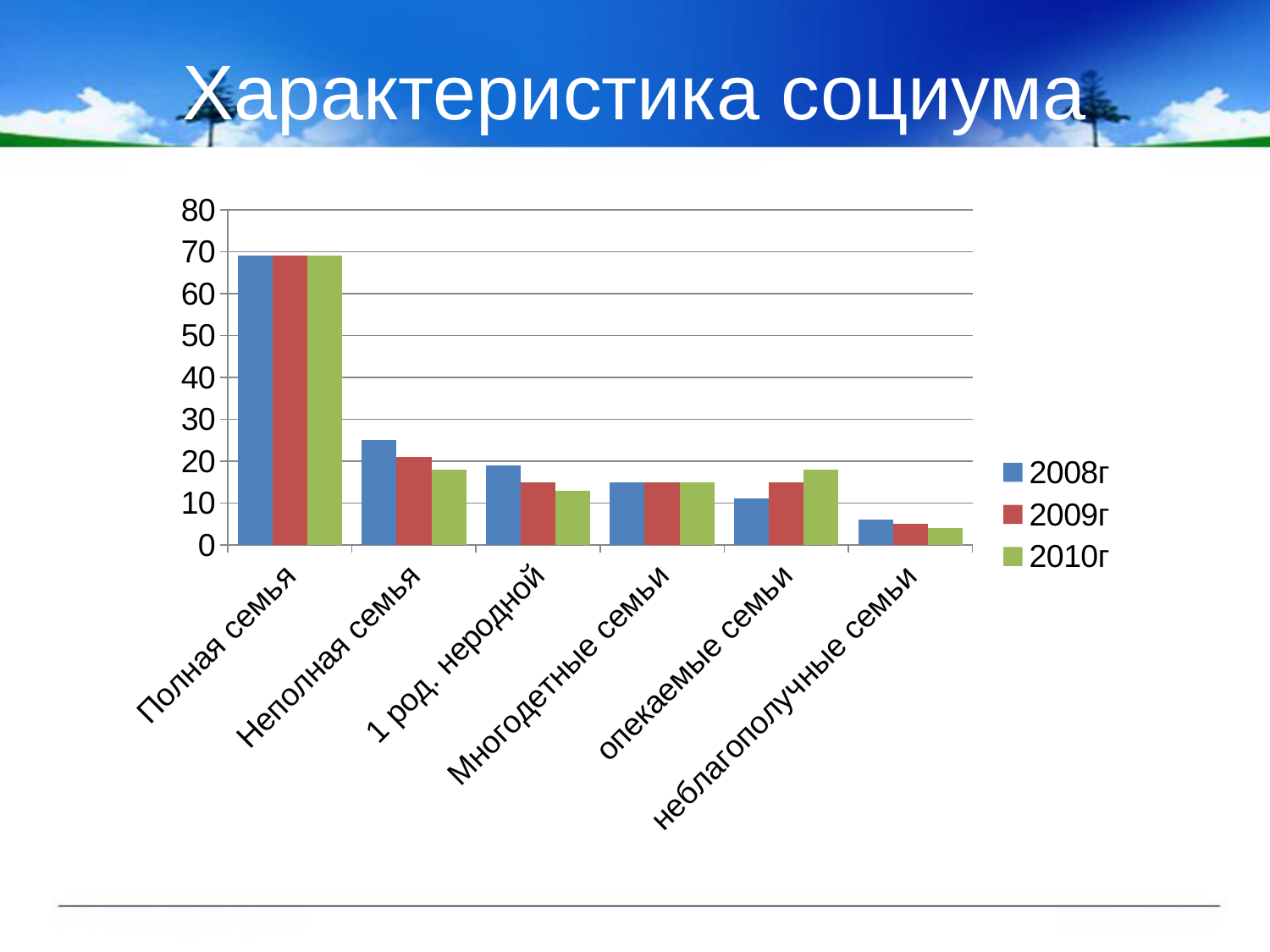
How many series does the legend list? 3 For опекаемые семьи, do the values rise or fall from 2008г to 2010г? rise How many categories are shown on the x axis? 6 For Неполная семья, which is larger: the value for 2008г or for 2010г? 2008г Which category has the lowest value for 2010г? неблагополучные семьи Is the value for неблагополучные семьи in 2008г greater or less than 10? less What is the title of the slide? Характеристика социума Which category has the highest value for 2008г? Полная семья What kind of chart is shown on the slide? bar chart Is the value for Полная семья in 2008г greater or less than 60? greater Is the value for опекаемые семьи in 2010г greater or less than 10? greater